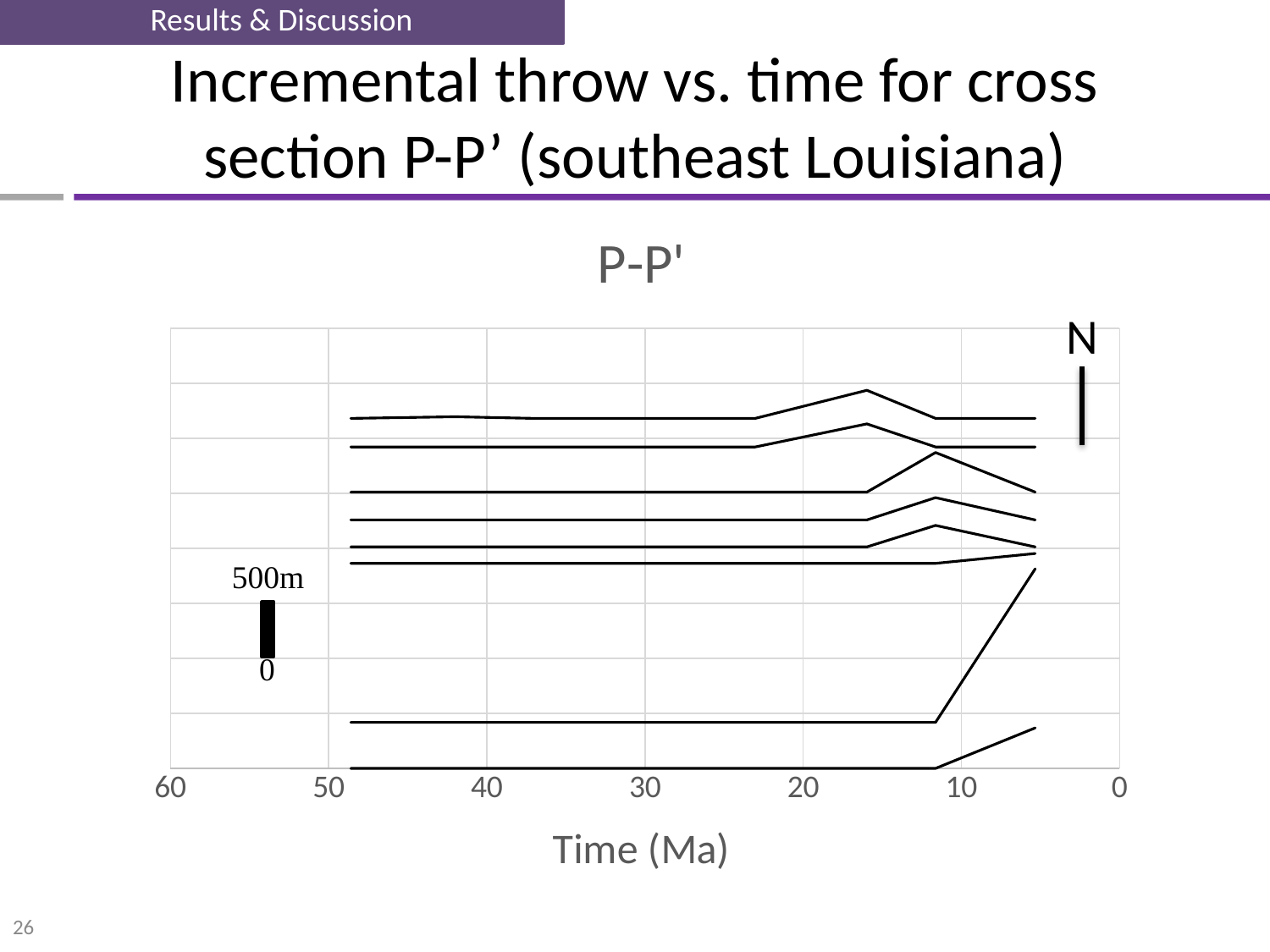
How many tick labels are shown along the x axis of the chart? 7 How many separate lines are plotted on the chart? 8 What is the rightmost value shown on the x axis of the chart? 0 Does the second line from the bottom stay flat or rise sharply as time approaches 0 Ma on the right side of the chart? rise sharply What kind of chart is shown on the slide? line chart What is the leftmost value shown on the x axis of the chart? 60 Does the chart include a legend? No What is the title of the chart? P-P' What length does the vertical scale bar on the chart represent? 500m Do the x-axis values increase or decrease from left to right on the chart? decrease What is the label of the x axis of the chart? Time (Ma)